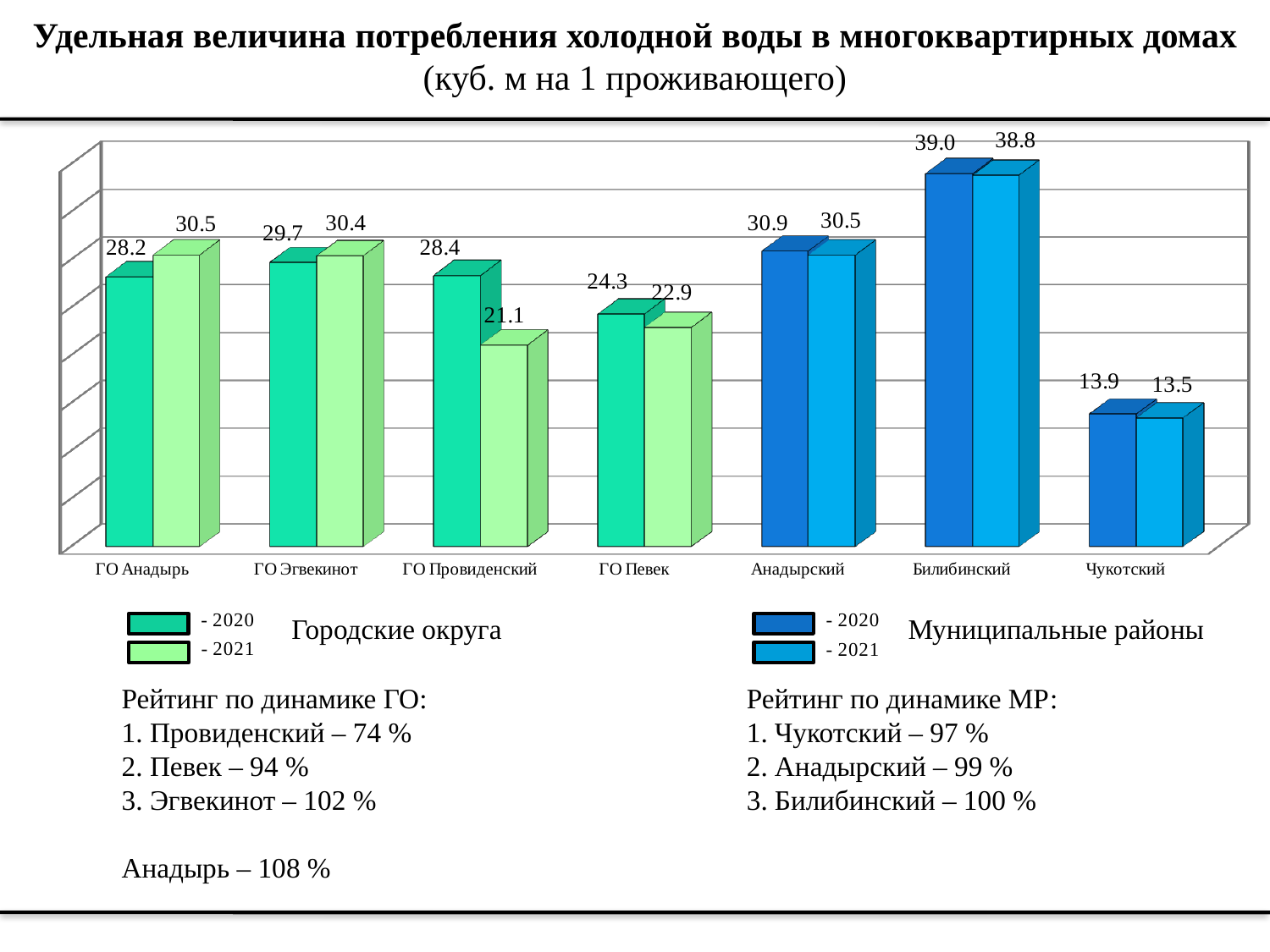
Which category has the lowest 2021 value? Чукотский What is the 2021 value for ГО Провиденский? 21.1 What kind of chart is shown on the slide? Bar chart What is the 2020 value for ГО Анадырь? 28.2 Which category has the highest 2020 value? Билибинский What is the difference between the 2021 values for Билибинский and Анадырский? 8.3 What is the 2021 value for Билибинский? 38.8 What is the difference between the 2020 and 2021 values for ГО Провиденский? 7.3 Which two years does the legend list for the Городские округа group? 2020 and 2021 What is the 2020 value for Чукотский? 13.9 How many categories are shown on the x axis of the chart? 7 Which is larger for ГО Певек: the 2020 value or the 2021 value? 2020